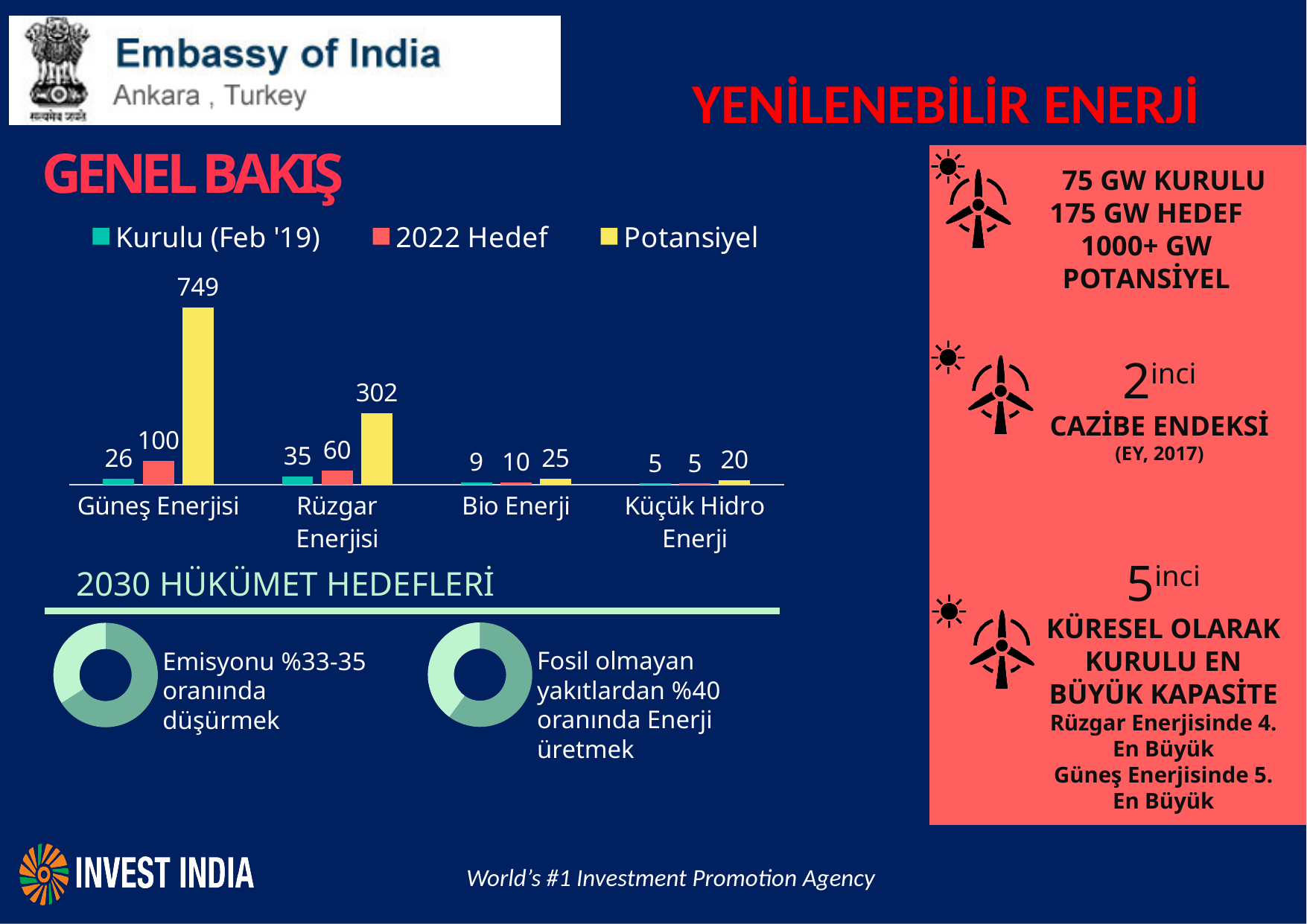
In the bar chart, what is the 2022 Hedef value for Bio Enerji? 10 Which series in the bar chart is shown in yellow? Potansiyel In the bar chart, what is the difference between the Potansiyel values for Güneş Enerjisi and Rüzgar Enerjisi? 447 In the bar chart, what is the Kurulu (Feb '19) value for Rüzgar Enerjisi? 35 In the bar chart, which category has the lowest 2022 Hedef value? Küçük Hidro Enerji What kind of chart is used under the heading GENEL BAKIŞ? Bar chart How many categories are shown on the x axis of the bar chart? 4 In the bar chart, what is the difference between the 2022 Hedef and Kurulu (Feb '19) values for Güneş Enerjisi? 74 In the bar chart, what is the Potansiyel value for Güneş Enerjisi? 749 How many series does the legend of the bar chart list? 3 In the bar chart, which category has the highest Potansiyel value? Güneş Enerjisi In the bar chart, which is larger: the Kurulu (Feb '19) value for Güneş Enerjisi or for Rüzgar Enerjisi? Rüzgar Enerjisi